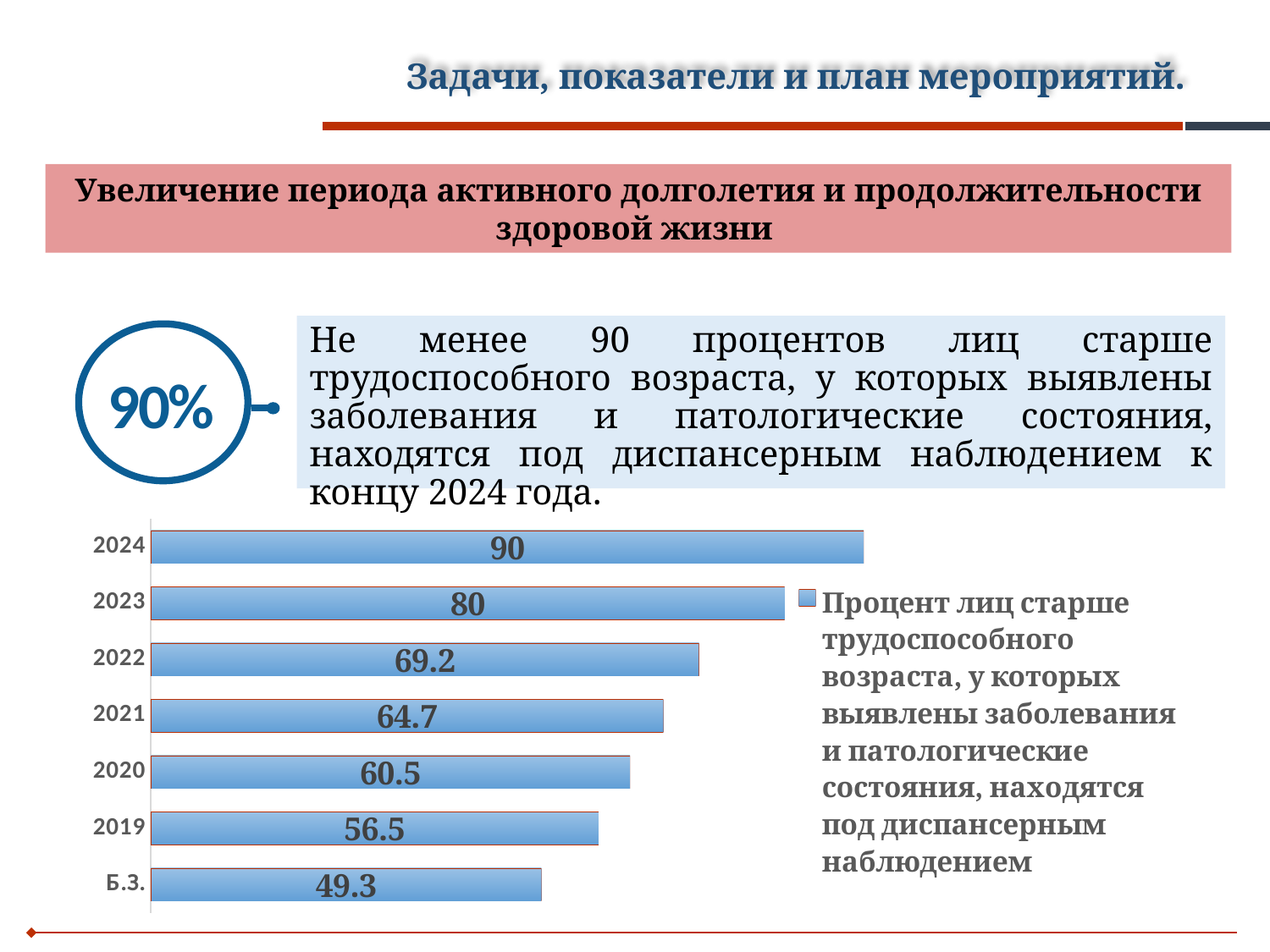
Which category has the lowest value? Б.З. What is the value for Б.З.? 49.3 Which category has the highest value? 2024 Which is larger, the value for 2022 or the value for 2021? 2022 How many categories are shown in the chart? 7 What is the difference between the values for 2020 and 2019? 4 What kind of chart is shown? bar chart What is the difference between the values for 2024 and 2023? 10 Do the values rise or fall from Б.З. to 2024? rise How many series does the legend list? 1 What is the value for 2021? 64.7 What is the value for 2024? 90